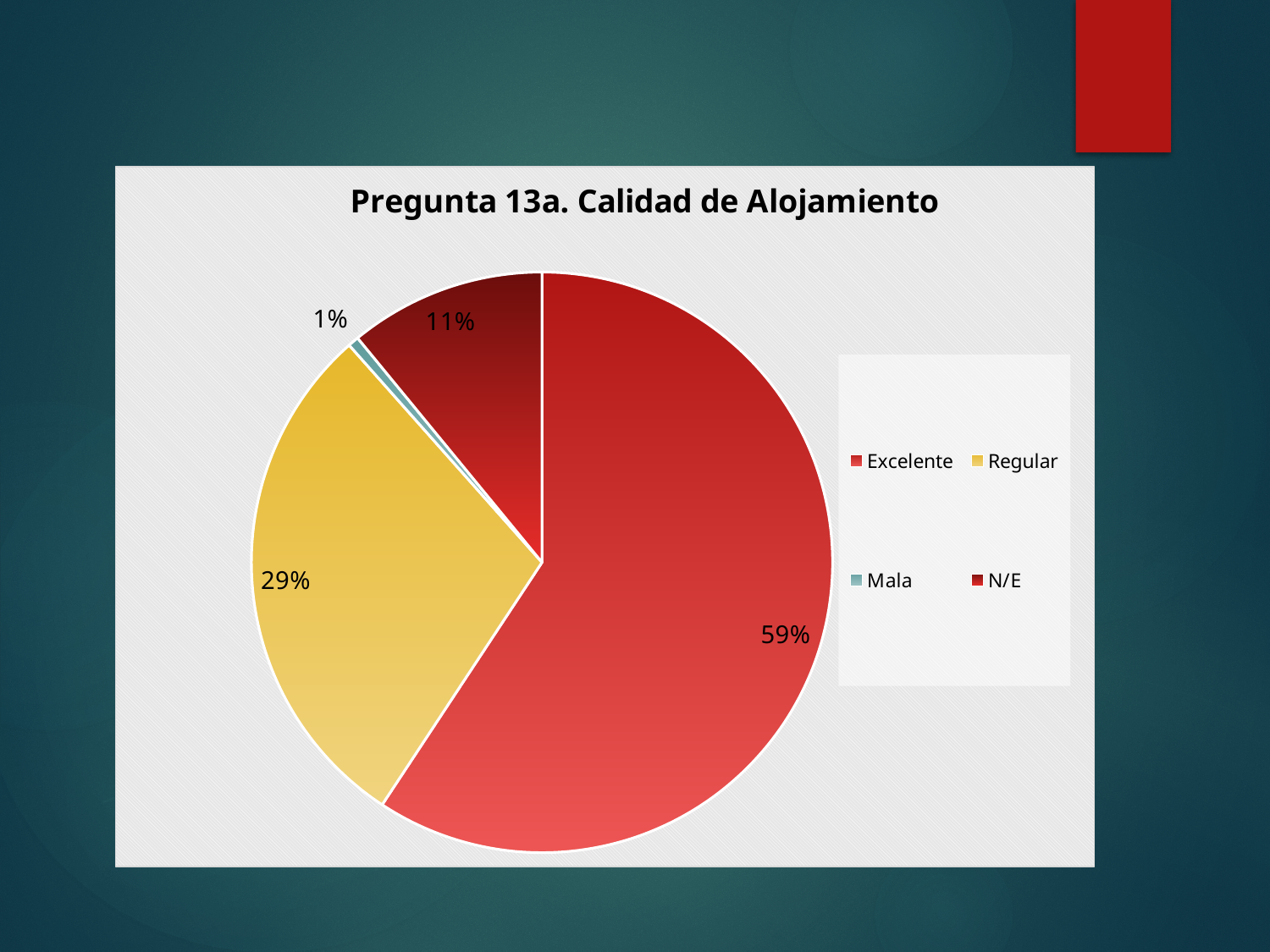
What is the difference in percentage points between Excelente and Regular? 30 What type of chart is shown on the slide? pie chart Which category has the largest share of the pie? Excelente What percentage of the pie is N/E? 11% What percentage of the pie is Mala? 1% What percentage of the pie is Excelente? 59% Which is larger, the share for Regular or the share for N/E? Regular What percentage of the pie is Regular? 29% How many categories does the legend list? 4 What colour is the Regular slice? yellow What is the title of the chart? Pregunta 13a. Calidad de Alojamiento Which category has the smallest share of the pie? Mala